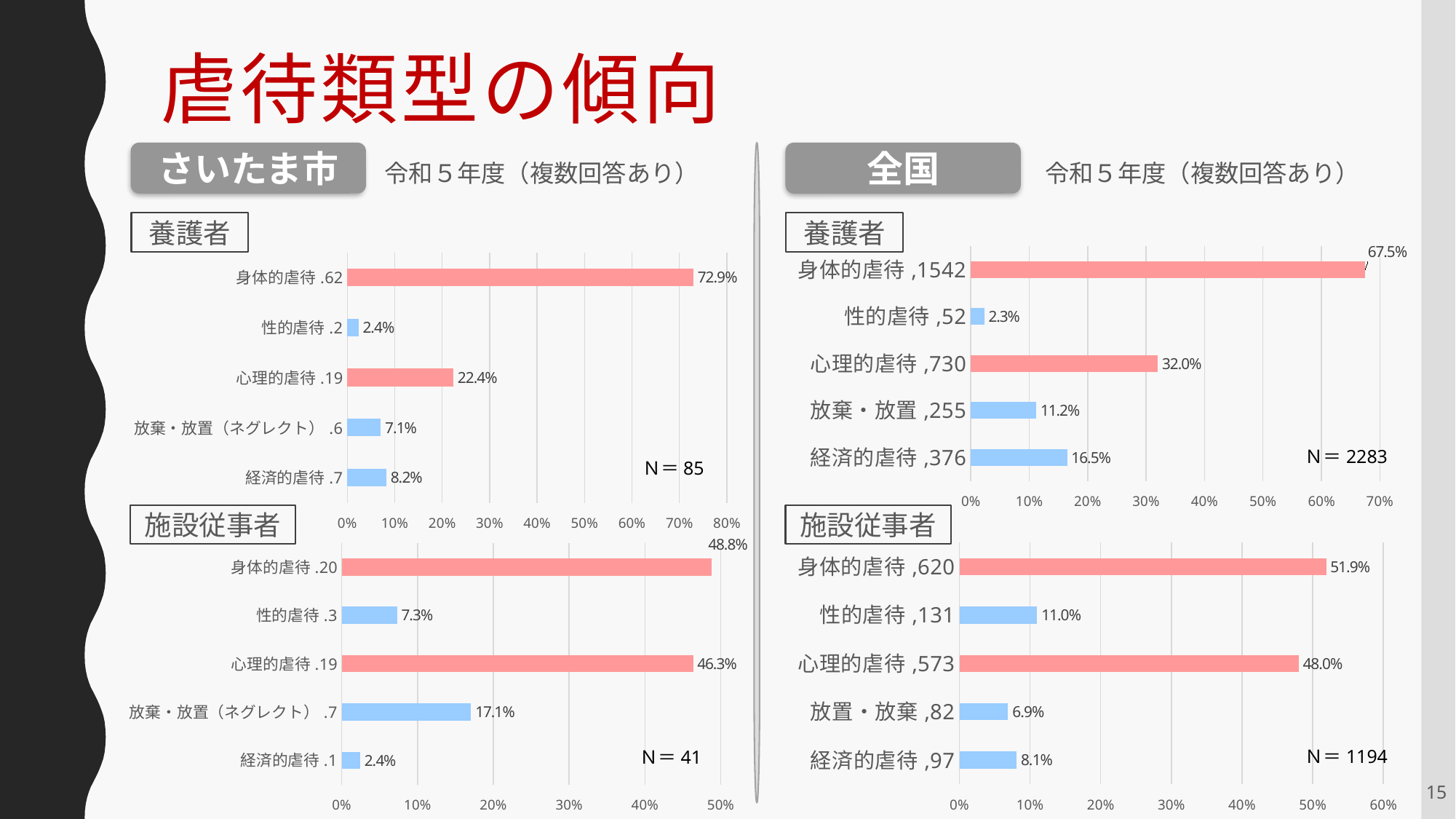
In the 全国 養護者 chart (top right), which is larger, 放棄・放置 or 経済的虐待? 経済的虐待 In the さいたま市 施設従事者 chart (bottom left), what is the value for 放棄・放置（ネグレクト）? 17.1% What type of chart is the 全国 養護者 chart (top right)? Bar chart In the さいたま市 施設従事者 chart (bottom left), what is the difference between 身体的虐待 and 心理的虐待? 2.5% In the 全国 養護者 chart (top right), what is the value for 心理的虐待? 32.0% How many categories are shown in the さいたま市 養護者 chart (top left)? 5 In the さいたま市 養護者 chart (top left), which category has the lowest value? 性的虐待 In the さいたま市 養護者 chart (top left), what is the value for 身体的虐待? 72.9% In the 全国 施設従事者 chart (bottom right), which category has the highest value? 身体的虐待 What is the N value shown on the さいたま市 施設従事者 chart (bottom left)? N＝41 In the 全国 施設従事者 chart (bottom right), what is the value for 性的虐待? 11.0% In the 全国 施設従事者 chart (bottom right), what is the difference between 身体的虐待 and 心理的虐待? 3.9%